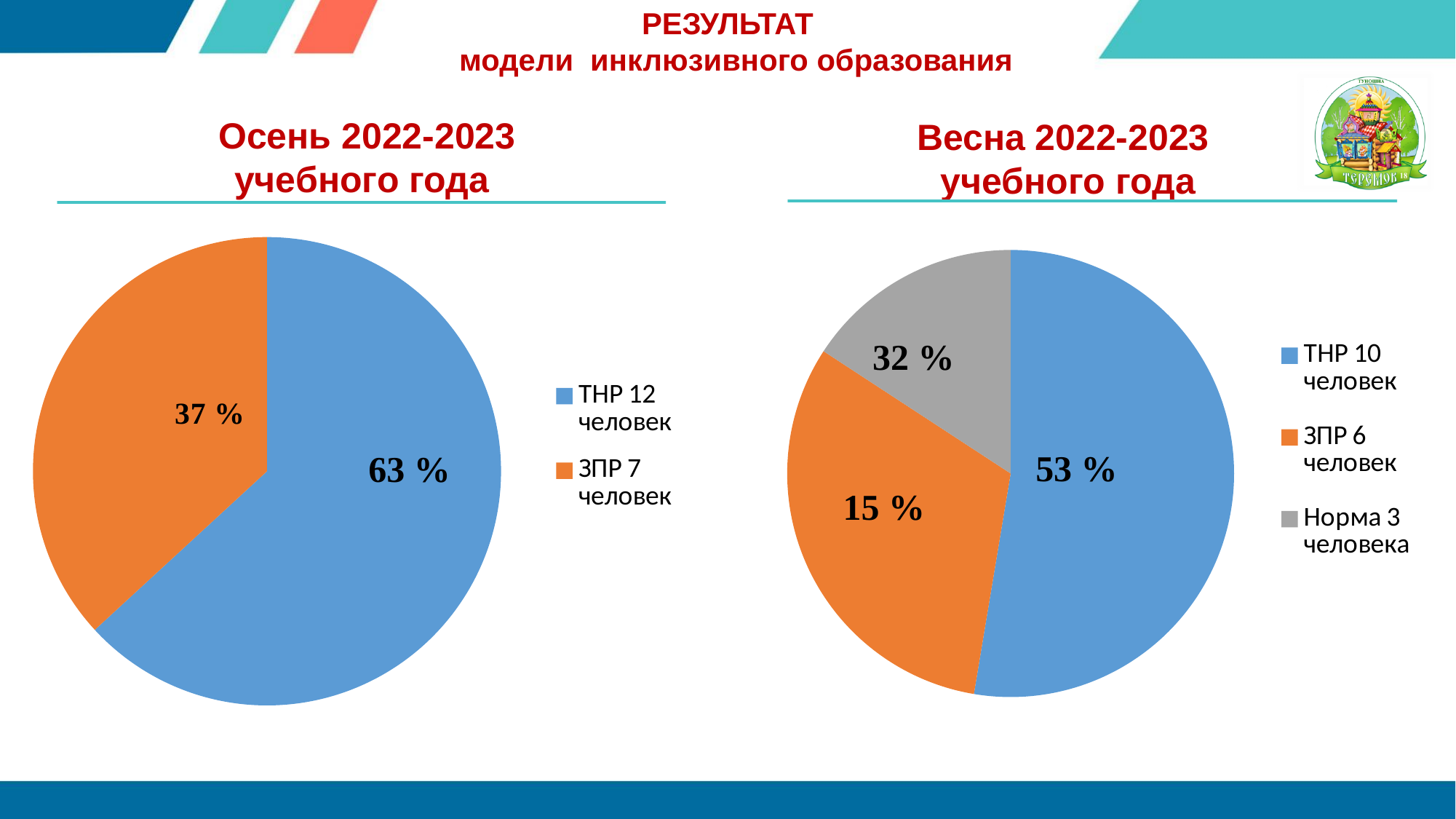
In the left chart (Осень 2022-2023 учебного года), which category has the largest slice? ТНР In the left chart (Осень 2022-2023 учебного года), by how many percentage points does the ТНР share exceed the ЗПР share? 26 According to the legend of the right chart (Весна 2022-2023 учебного года), how many people are in the Норма group? 3 In the left chart (Осень 2022-2023 учебного года), what share of the pie is labelled for ЗПР? 37 % What kind of chart is the left chart titled "Осень 2022-2023 учебного года"? pie chart In the right chart (Весна 2022-2023 учебного года), what share of the pie is labelled for ТНР? 53 % How many slices does the left chart (Осень 2022-2023 учебного года) have? 2 How many slices does the right chart (Весна 2022-2023 учебного года) have? 3 In the right chart (Весна 2022-2023 учебного года), which category has the largest slice? ТНР In the left chart (Осень 2022-2023 учебного года), what share of the pie is labelled for ТНР? 63 % According to the legend of the left chart (Осень 2022-2023 учебного года), how many people are in the ТНР group? 12 In the right chart (Весна 2022-2023 учебного года), what colour represents the Норма group? grey